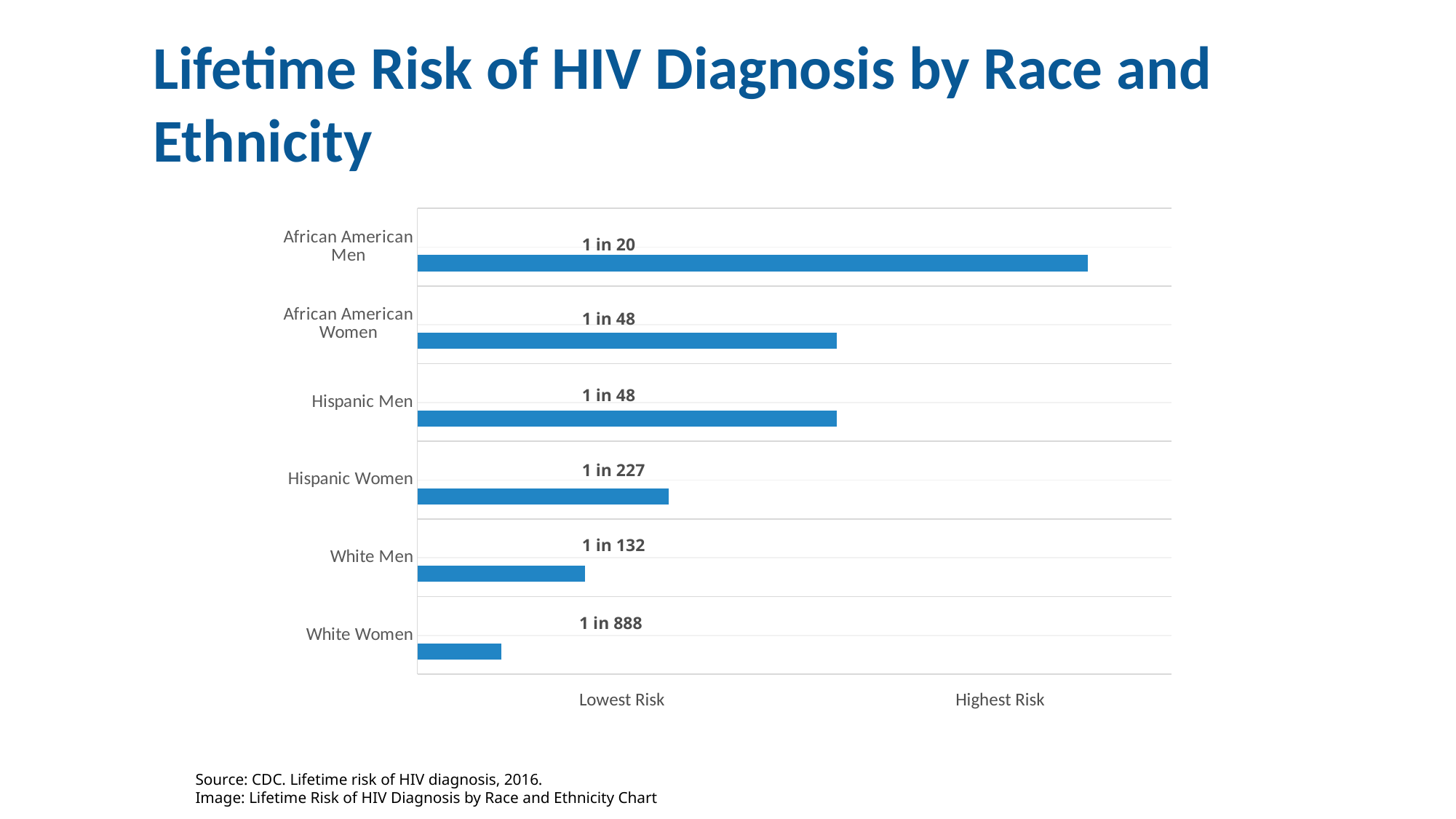
Which group has the longest bar, indicating the highest lifetime risk of HIV diagnosis? African American Men How many race and gender groups are shown in the chart? 6 Which group has the shortest bar, indicating the lowest lifetime risk of HIV diagnosis? White Women What is the lifetime risk of HIV diagnosis shown for White Women? 1 in 888 What are the two labels shown along the horizontal axis of the chart? Lowest Risk and Highest Risk What is the lifetime risk of HIV diagnosis shown for White Men? 1 in 132 What is the lifetime risk of HIV diagnosis shown for Hispanic Women? 1 in 227 What is the lifetime risk of HIV diagnosis shown for African American Women? 1 in 48 What is the lifetime risk of HIV diagnosis shown for African American Men? 1 in 20 Which group has a higher lifetime risk of HIV diagnosis, African American Men or White Women? African American Men What is the lifetime risk of HIV diagnosis shown for Hispanic Men? 1 in 48 What kind of chart is shown on the slide? Bar chart